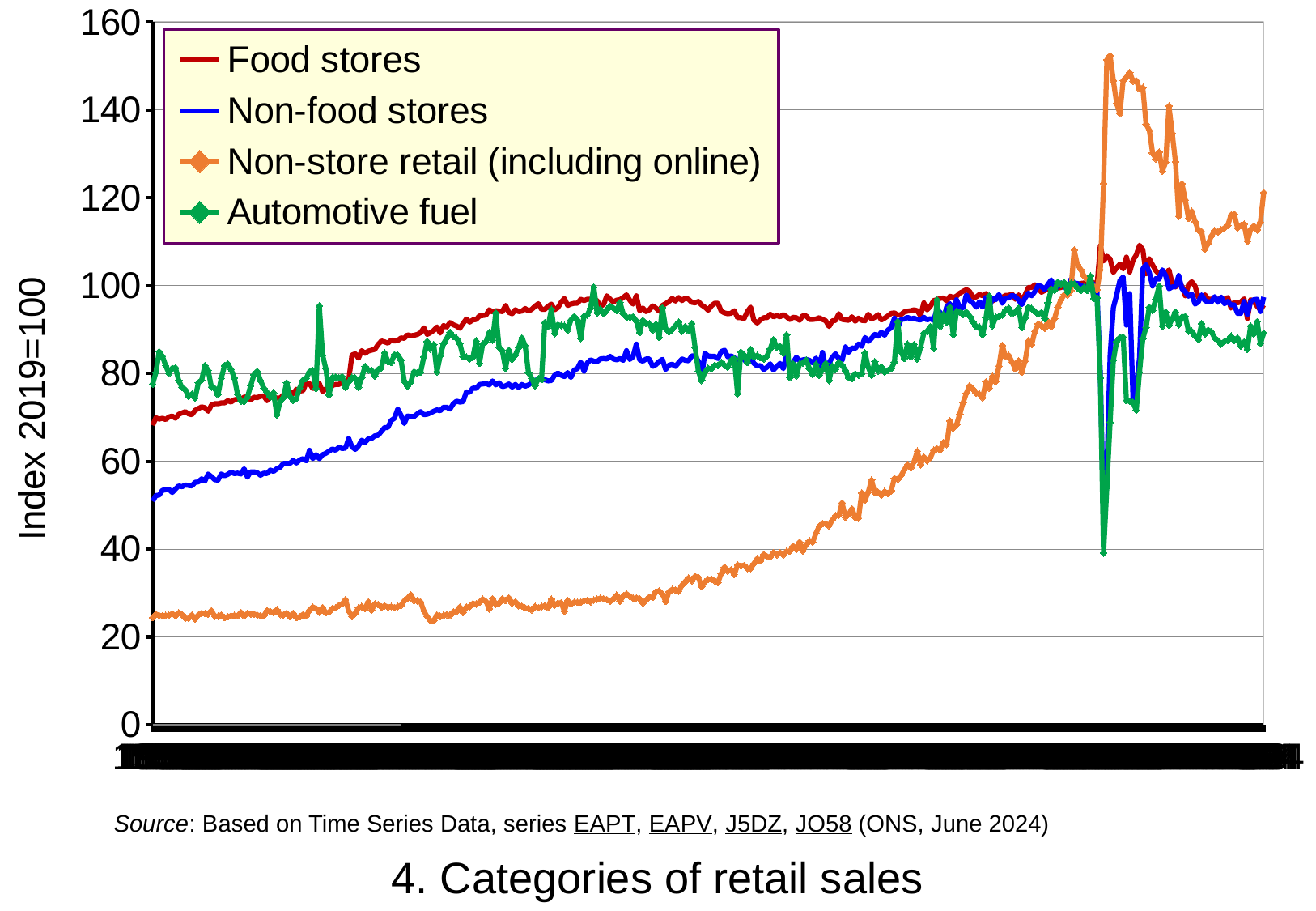
What kind of chart is shown on the slide? line chart How many series does the legend list? 4 At the left edge of the chart, is the value for Non-food stores greater or less than 60? less At the left edge of the chart, is the value for Food stores greater or less than 60? greater What is the label on the vertical axis? Index 2019=100 At the left edge of the chart, which is higher: Food stores or Non-food stores? Food stores Which series are listed in the legend? Food stores, Non-food stores, Non-store retail (including online), Automotive fuel At the left edge of the chart, which series has the lowest value? Non-store retail (including online) Is the peak value of the Non-store retail (including online) series greater or less than 140? greater Does the Non-store retail (including online) series generally rise or fall from left to right? rise At the right end of the chart, which series has the highest value? Non-store retail (including online)